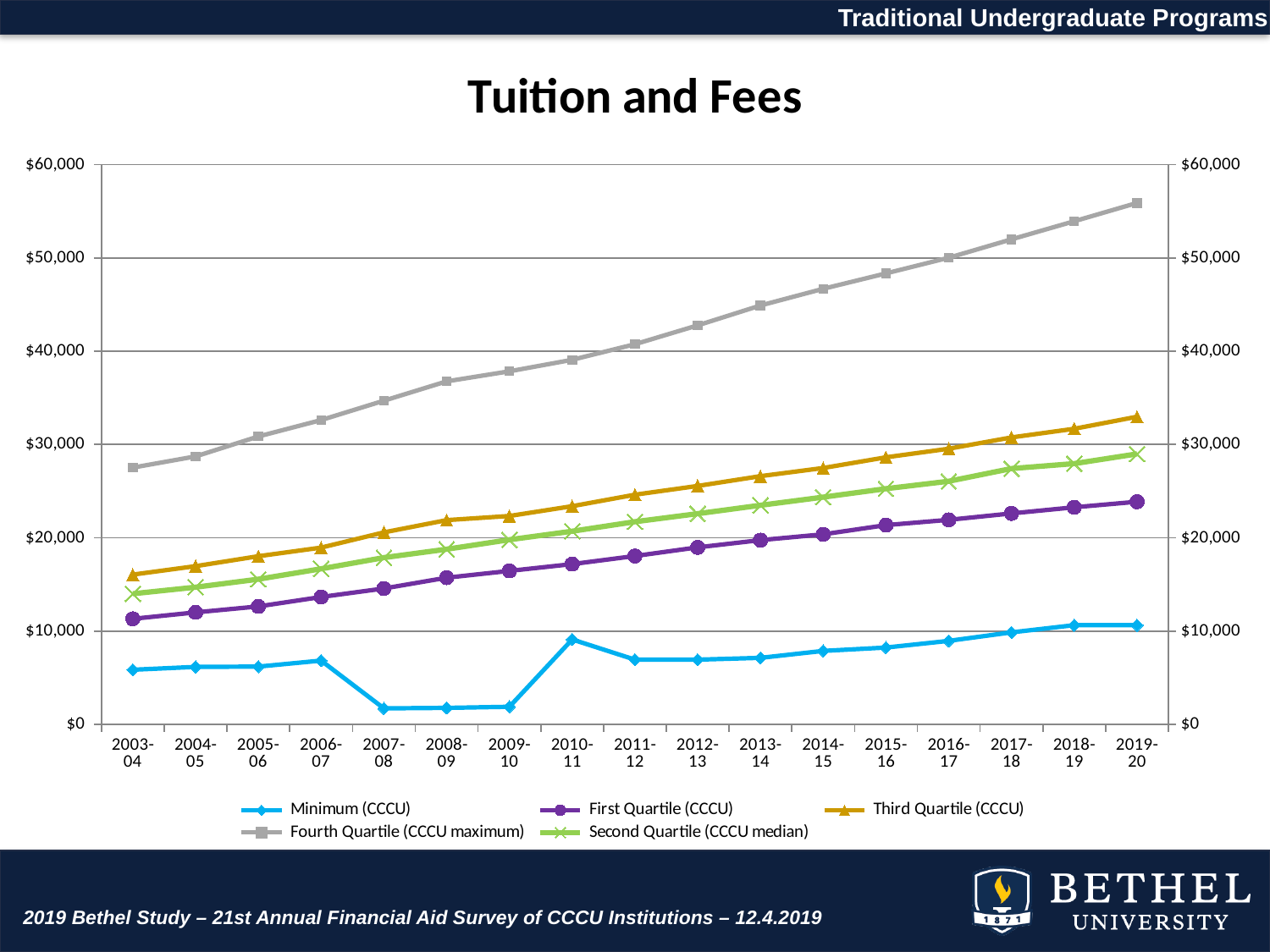
Is the Fourth Quartile (CCCU maximum) value for 2003-04 greater or less than $30,000? less Is the Third Quartile (CCCU) value for 2019-20 greater or less than $30,000? greater How many academic years are plotted along the x axis? 17 What kind of chart is shown on the slide? line chart Which series has the highest value in 2019-20? Fourth Quartile (CCCU maximum) Which series has the lowest value in 2019-20? Minimum (CCCU) Is the Minimum (CCCU) value for 2007-08 greater or less than $10,000? less How many series does the legend list? 5 In 2010-11, which is larger: the Third Quartile (CCCU) value or the First Quartile (CCCU) value? Third Quartile (CCCU) What is the title of the chart? Tuition and Fees Does the Fourth Quartile (CCCU maximum) series rise or fall from 2003-04 to 2019-20? rise